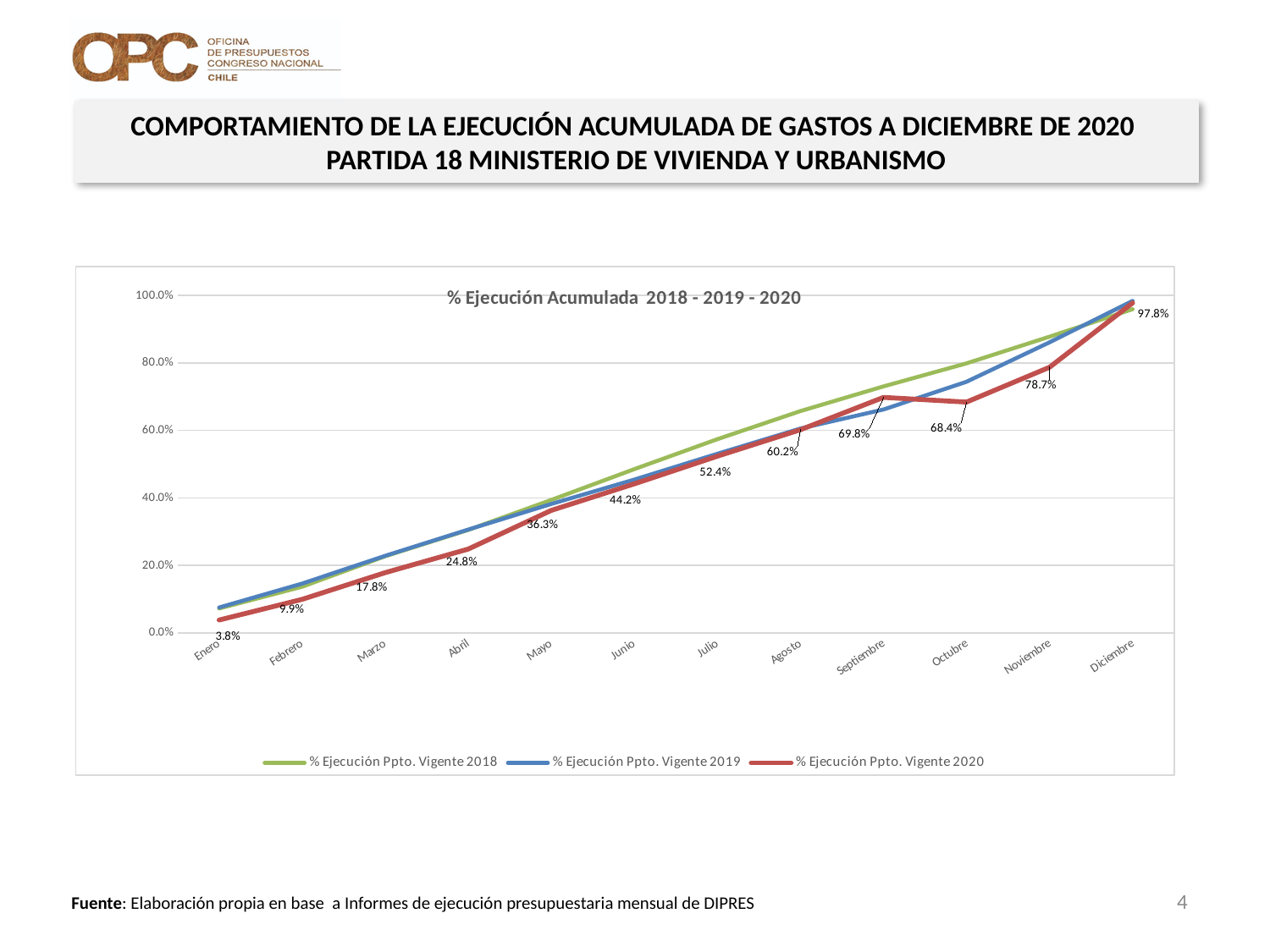
What is the difference between the % Ejecución Ppto. Vigente 2020 values for Noviembre and Octubre? 10.3% What is the value for % Ejecución Ppto. Vigente 2020 in Mayo? 36.3% Is the value for % Ejecución Ppto. Vigente 2019 in Octubre greater or less than 60.0%? greater In which month is the % Ejecución Ppto. Vigente 2020 series lowest? Enero What is the title of the chart? % Ejecución Acumulada 2018 - 2019 - 2020 What type of chart is shown on the slide? line chart How many series does the legend list? 3 What is the value for % Ejecución Ppto. Vigente 2020 in Enero? 3.8% How many months are plotted along the x axis? 12 What is the value for % Ejecución Ppto. Vigente 2020 in Diciembre? 97.8% Which is larger for % Ejecución Ppto. Vigente 2020: Septiembre or Octubre? Septiembre What is the value for % Ejecución Ppto. Vigente 2020 in Septiembre? 69.8%